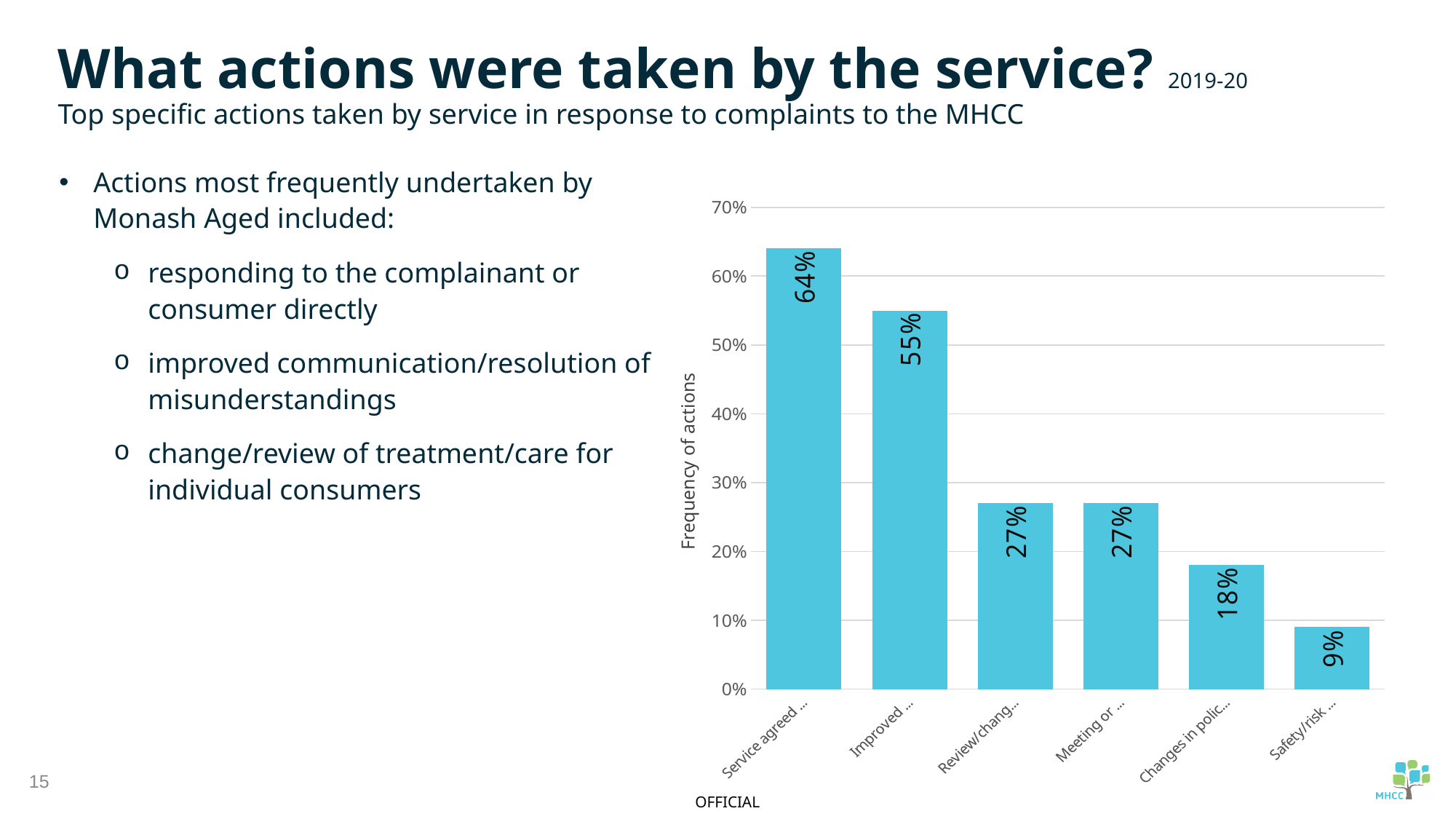
What is the value of the bar labelled 'Meeting or ...'? 27% What is the difference between the first bar (64%) and the second bar (55%)? 9 percentage points What is the value of the bar labelled 'Changes in polic...'? 18% What kind of chart is shown on the slide? Bar chart How many bars (categories) are plotted in the chart? 6 What is the highest tick value shown on the vertical axis? 70% Do the bar values rise or fall from left to right across the chart? Fall Which category has the lowest value in the chart? Safety/risk ... (the last bar), 9% Which category has the highest value in the chart? Service agreed ... (the first bar), 64% Which is larger: the value for 'Improved ...' or the value for 'Changes in polic...'? Improved ... (55%) What is the value of the second bar, labelled 'Improved ...'? 55% What is the title of the vertical axis of the chart? Frequency of actions